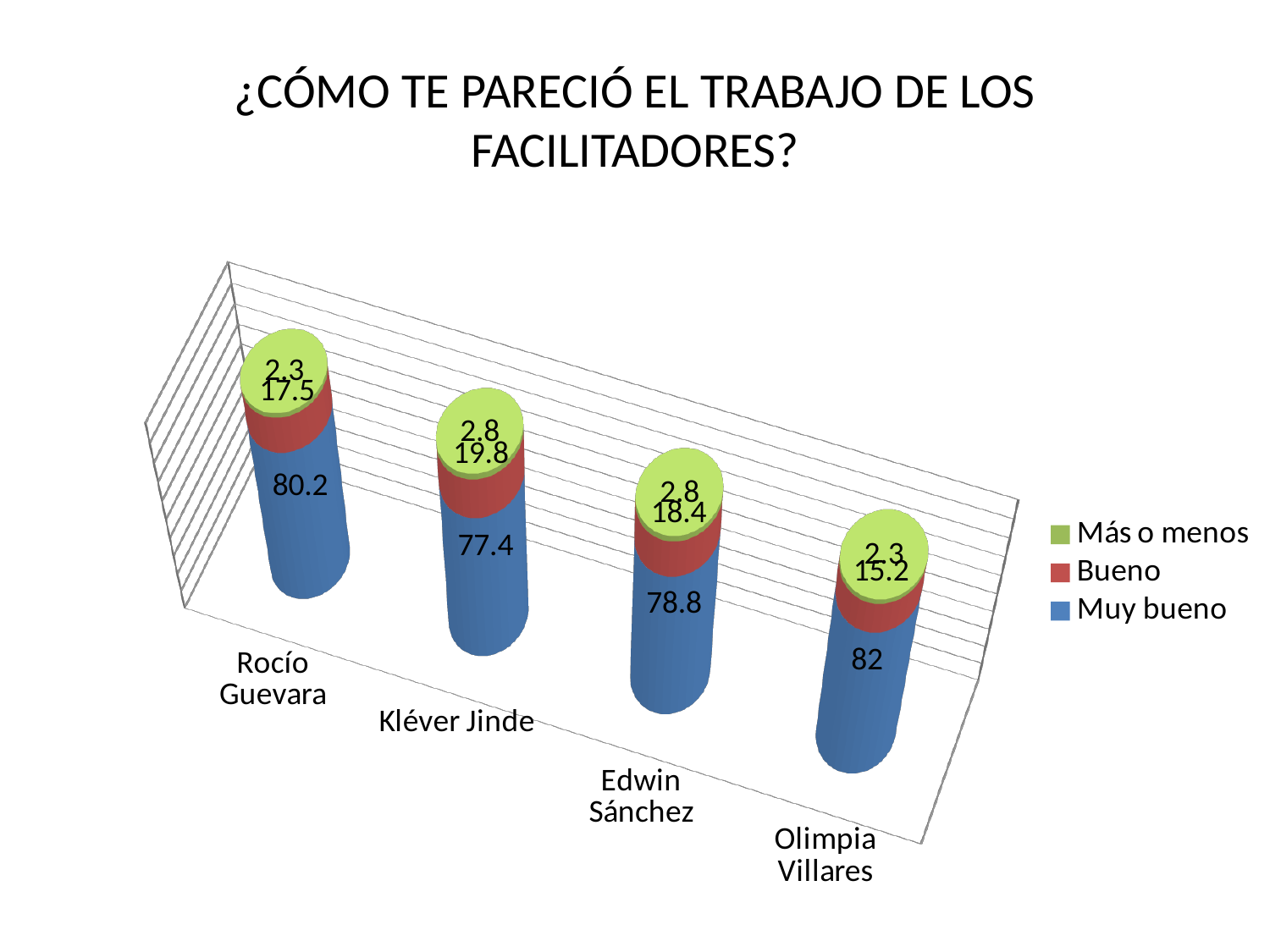
What is the total of the stacked bar for Rocío Guevara? 100 What kind of chart is shown on the slide? Stacked bar chart What is the "Muy bueno" value for Olimpia Villares? 82 How many series does the legend list? 3 What is the "Bueno" value for Kléver Jinde? 19.8 Which facilitator has the lowest "Bueno" value? Olimpia Villares How many facilitators are shown on the chart? 4 What is the "Muy bueno" value for Rocío Guevara? 80.2 What is the difference between the "Muy bueno" values for Olimpia Villares and Kléver Jinde? 4.6 What is the "Más o menos" value for Edwin Sánchez? 2.8 Which facilitator has the highest "Muy bueno" value? Olimpia Villares Which is larger, the "Bueno" value for Rocío Guevara or for Edwin Sánchez? Edwin Sánchez